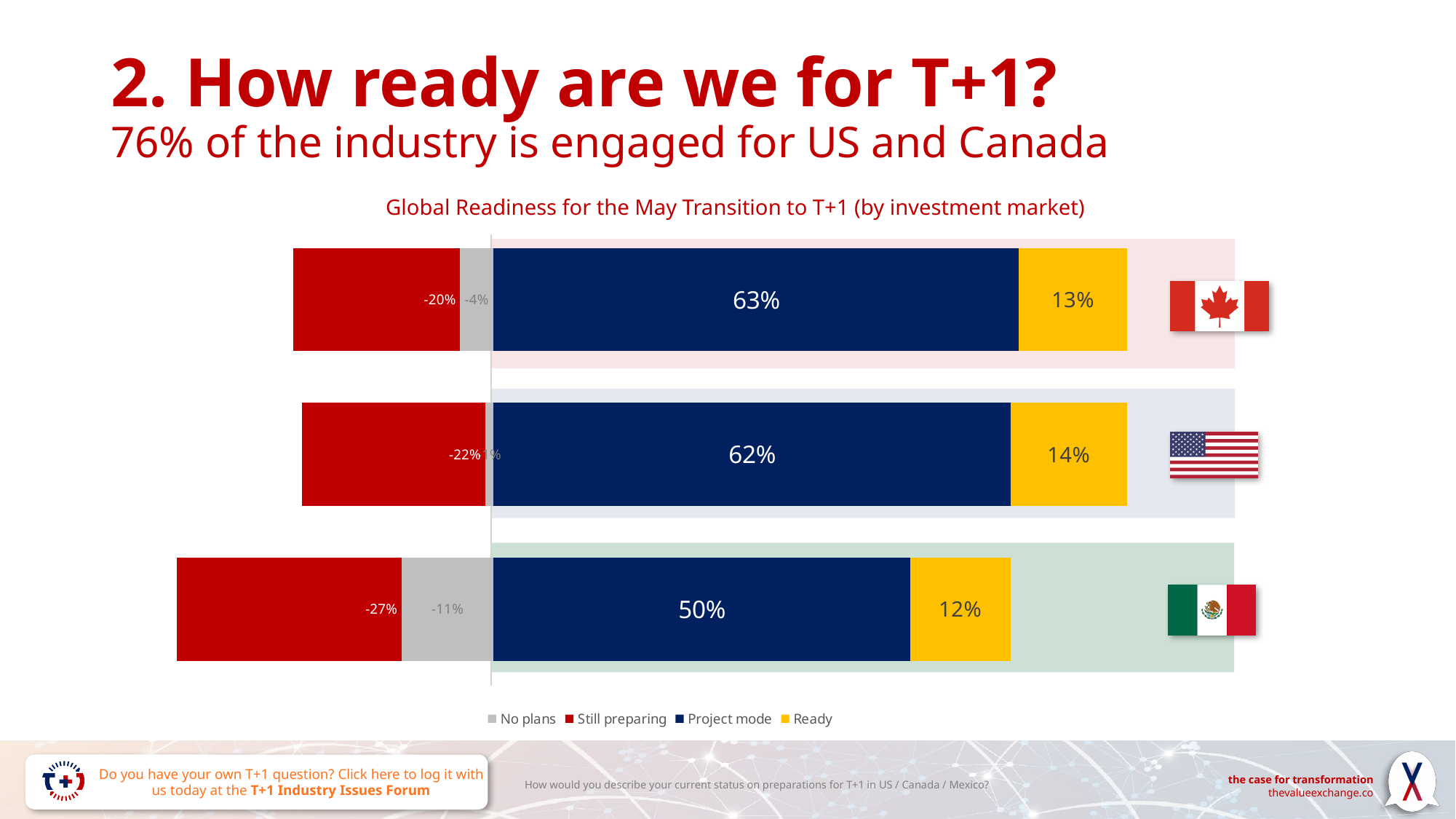
How many series does the legend list? 4 How many markets (bars) are shown in the chart? 3 What is the Ready value for the US? 14% What is the difference between the Project mode values for Canada and Mexico? 13% Which legend entry is shown in yellow? Ready Which market has the lowest Project mode value? Mexico What is the Project mode value for Canada? 63% What kind of chart is shown on the slide? Stacked bar chart Which market has the highest Ready value? US What is the title of the chart? Global Readiness for the May Transition to T+1 (by investment market) What is the No plans value for Mexico? -11% What is the Still preparing value for Mexico? -27%